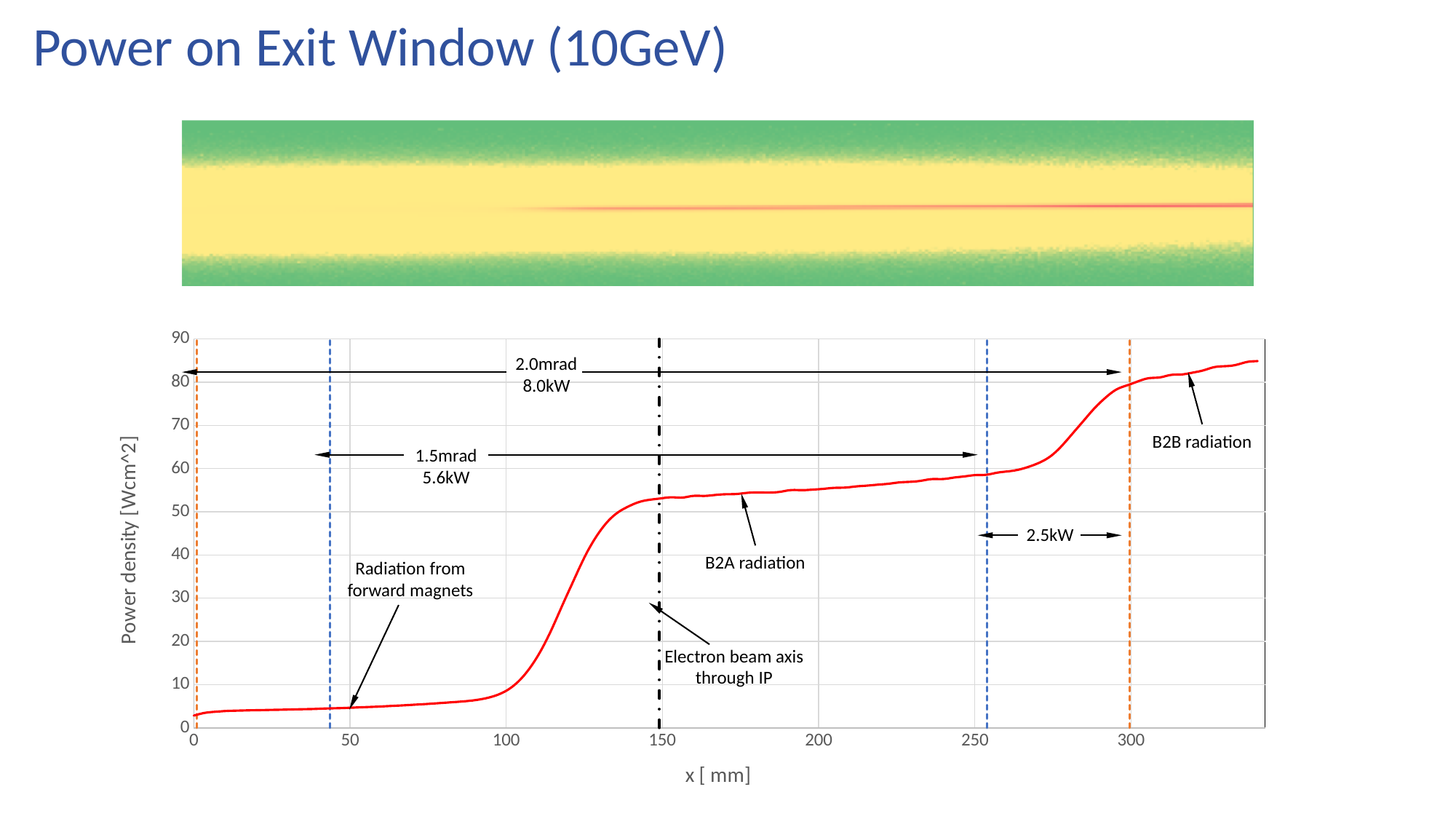
Is the power density at x = 0 mm greater or less than 10? less Is the power density at x = 50 mm greater or less than 10? less What is the label of the y axis of the chart? Power density [Wcm^2] Does the power density generally rise or fall as x increases from 0 to 300 mm? rise Is the power density at x = 100 mm greater or less than 20? less What kind of chart is shown on the slide? line chart What is the label of the x axis of the chart? x [ mm] Which has the higher power density: x = 50 mm or x = 250 mm? x = 250 mm